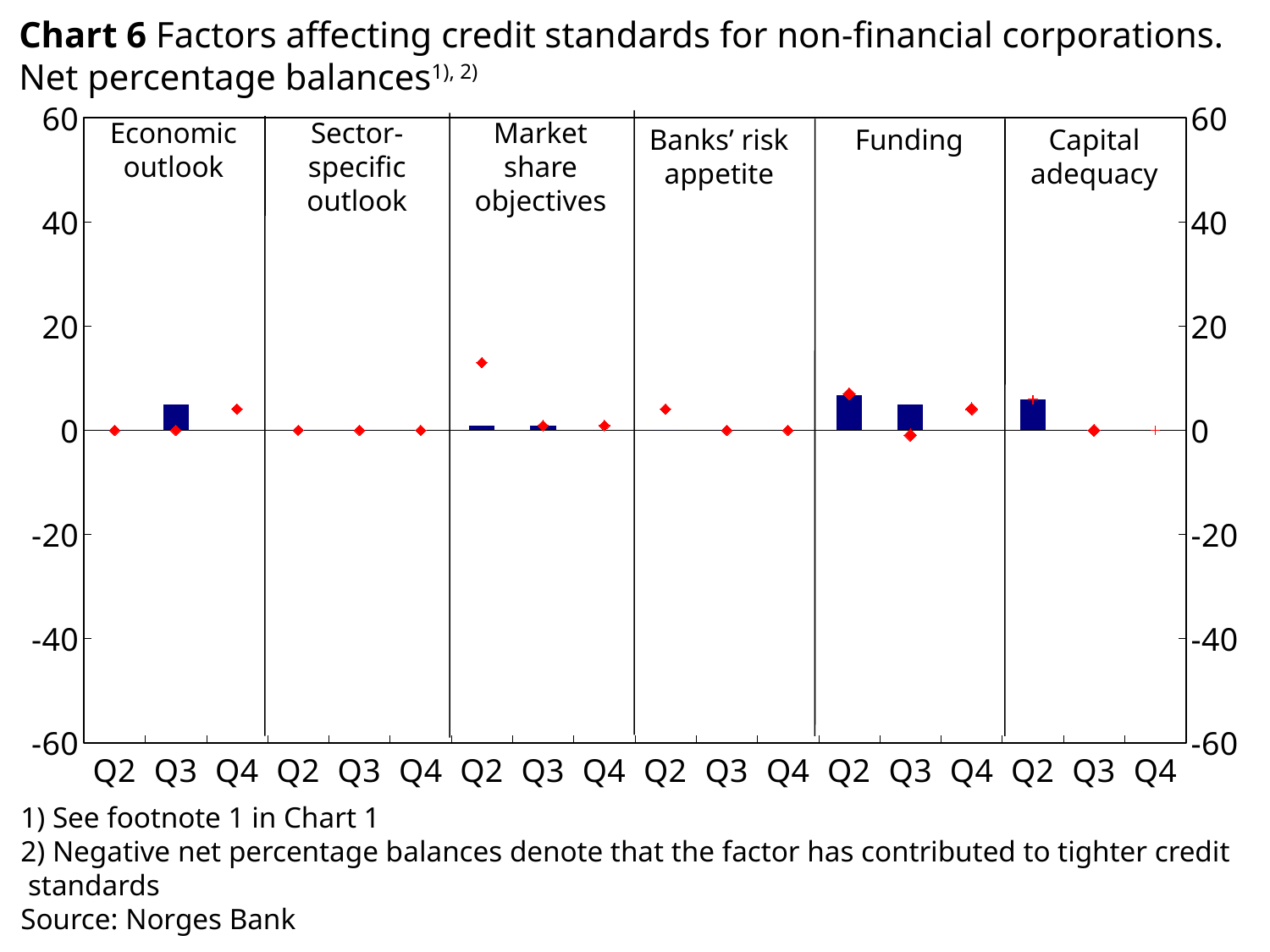
Is the bar for Q2 under Capital adequacy greater or less than 0? greater How many factor panels are shown in the chart? 6 Which factor panel contains the highest red marker value? Market share objectives What kind of chart is shown on the slide? Bar chart with red diamond markers (combination bar and marker chart) Is the bar for Q3 under Economic outlook greater or less than 0? greater Which is larger: the Q2 red marker under Market share objectives or the Q4 red marker under Economic outlook? Market share objectives Is the red marker for Q2 under Market share objectives greater or less than 20? less What is the source given for the chart? Norges Bank How many quarters are shown within each factor panel? 3 Which is larger: the Q3 bar under Economic outlook or the Q3 bar under Sector-specific outlook? Economic outlook What is the highest value shown on the vertical axis? 60